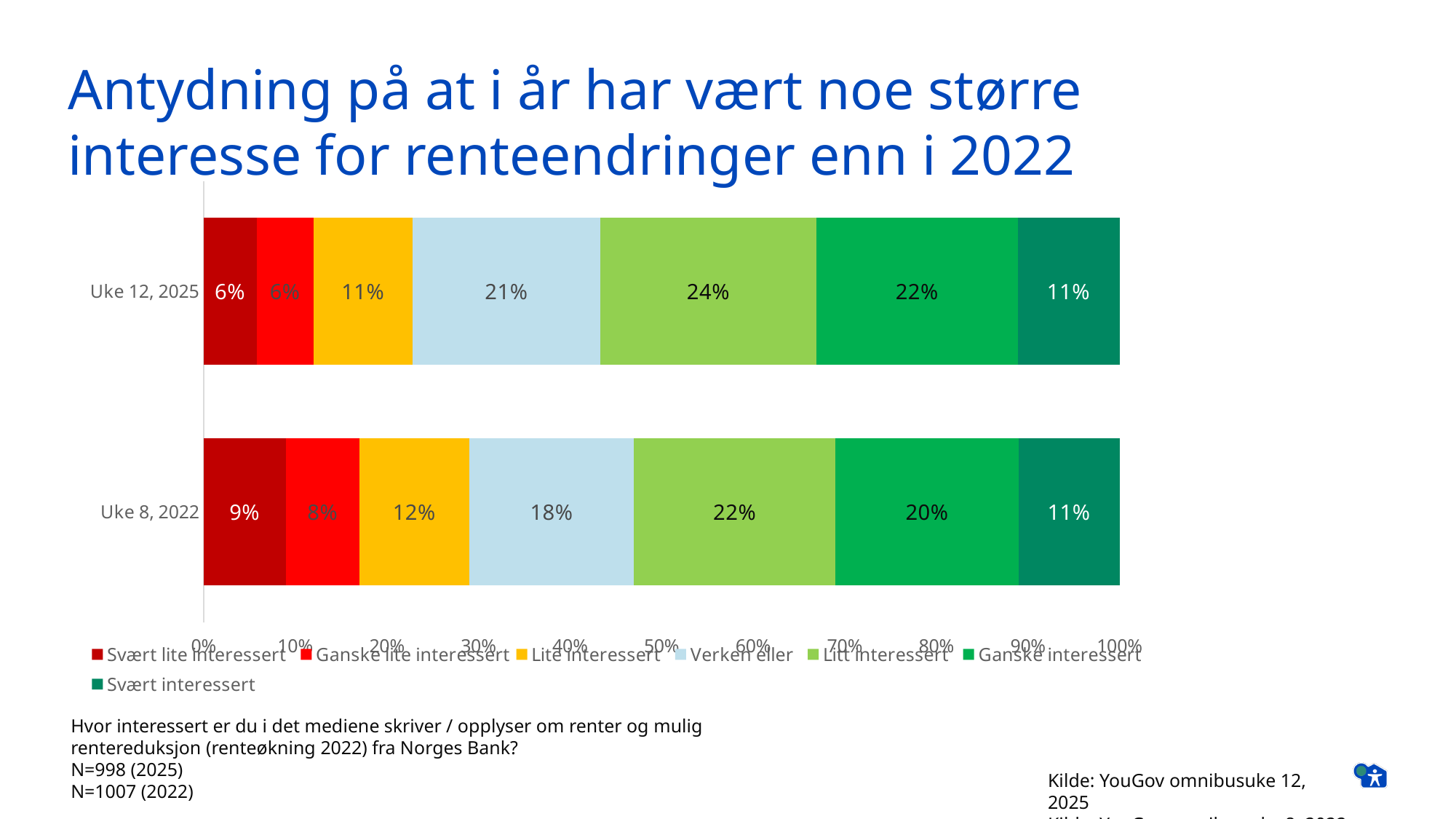
What is the difference in percentage points between "Svært lite interessert" in Uke 8, 2022 and in Uke 12, 2025? 3 percentage points What is the value for "Svært lite interessert" in Uke 8, 2022? 9% Which is larger: "Verken eller" in Uke 12, 2025 or "Verken eller" in Uke 8, 2022? Uke 12, 2025 Which response category has the largest share in the Uke 12, 2025 bar? Litt interessert What is the value for "Litt interessert" in Uke 12, 2025? 24% What kind of chart is shown on the slide? Stacked bar chart How many series does the legend list? 7 How many bars (categories) are plotted in the chart? 2 What is the value for "Ganske interessert" in Uke 8, 2022? 20% Which legend entry is shown in dark green (the last segment of each bar)? Svært interessert Which response category has the smallest share in the Uke 8, 2022 bar? Ganske lite interessert What is the value for "Verken eller" in Uke 12, 2025? 21%